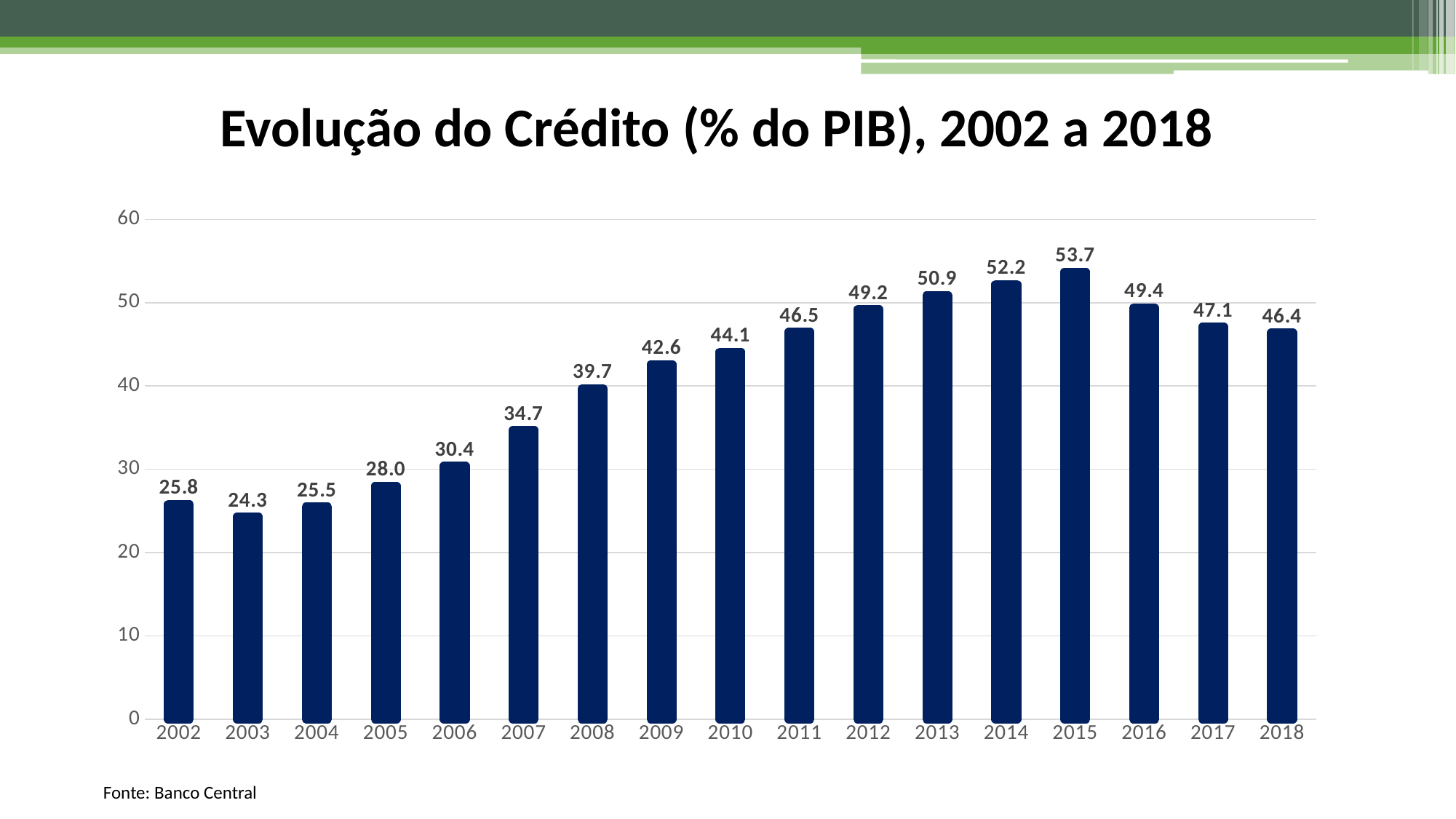
What is the difference between the values for 2008 and 2007? 5.0 How many years are shown on the x axis? 17 What is the value for 2018? 46.4 Is the value for 2010 greater or less than 40? greater What is the difference between the values for 2015 and 2002? 27.9 What is the title of the chart? Evolução do Crédito (% do PIB), 2002 a 2018 What kind of chart is this? bar chart Which is larger, the value for 2012 or the value for 2016? 2016 Which year has the lowest value? 2003 What is the value for 2002? 25.8 Which year has the highest value? 2015 What is the value for 2015? 53.7